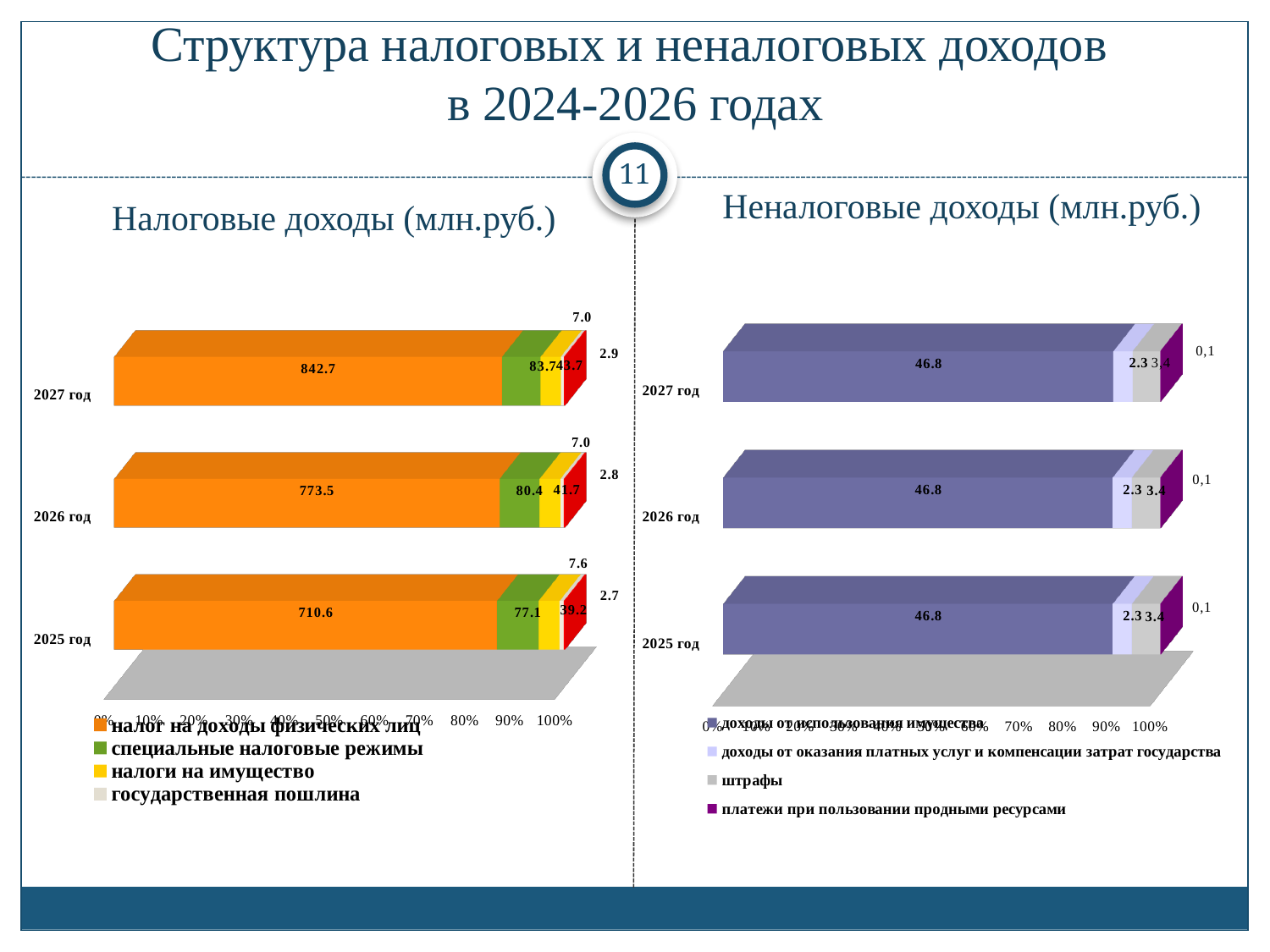
In the chart titled "Налоговые доходы (млн.руб.)", what is the value for "налог на доходы физических лиц" in 2027 год? 842.7 What kind of chart is the chart titled "Налоговые доходы (млн.руб.)"? stacked bar chart In the chart titled "Неналоговые доходы (млн.руб.)", what is the value for "доходы от использования имущества" in 2026 год? 46.8 In the chart titled "Неналоговые доходы (млн.руб.)", what is the value for "штрафы" in 2025 год? 3.4 In the chart titled "Налоговые доходы (млн.руб.)", what is the value for "налоги на имущество" in 2026 год? 41.7 In the chart titled "Налоговые доходы (млн.руб.)", what is the difference between the "налог на доходы физических лиц" values for 2027 год and 2025 год? 132.1 In the chart titled "Налоговые доходы (млн.руб.)", what is the value for "специальные налоговые режимы" in 2025 год? 77.1 How many year categories are shown in the chart titled "Неналоговые доходы (млн.руб.)"? 3 In the chart titled "Налоговые доходы (млн.руб.)", does the value for "налог на доходы физических лиц" rise or fall from 2025 год to 2027 год? rise In the chart titled "Налоговые доходы (млн.руб.)", which year has the highest value for "налог на доходы физических лиц"? 2027 год In the chart titled "Неналоговые доходы (млн.руб.)", how many series does the legend list? 4 In the chart titled "Налоговые доходы (млн.руб.)", which is larger: "специальные налоговые режимы" in 2026 год or "налоги на имущество" in 2026 год? специальные налоговые режимы